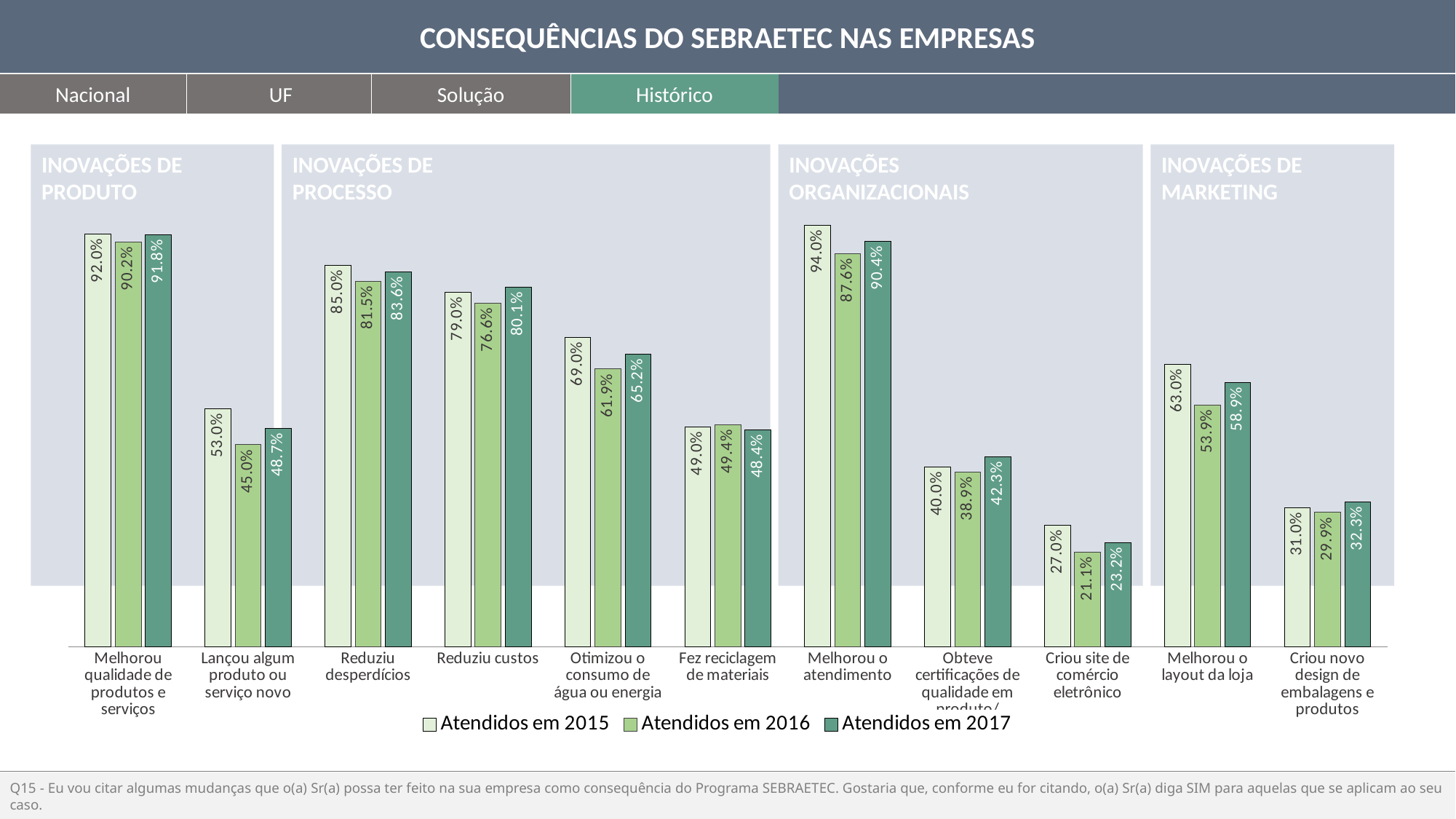
What is the difference between the "Atendidos em 2015" and "Atendidos em 2016" values for "Melhorou o layout da loja"? 9.1% Which category has the lowest value in the "Atendidos em 2015" series? Criou site de comércio eletrônico For "Lançou algum produto ou serviço novo", which is larger: the "Atendidos em 2016" value or the "Atendidos em 2017" value? Atendidos em 2017 How many categories are shown on the x axis of the chart? 11 What is the value for "Reduziu custos" in the "Atendidos em 2017" series? 80.1% What is the value for "Melhorou o atendimento" in the "Atendidos em 2015" series? 94.0% How many series does the legend list? 3 What is the value for "Criou site de comércio eletrônico" in the "Atendidos em 2016" series? 21.1% What kind of chart is shown on the slide? Bar chart Which category has the highest value in the "Atendidos em 2017" series? Melhorou qualidade de produtos e serviços What is the value for "Otimizou o consumo de água ou energia" in the "Atendidos em 2016" series? 61.9% Which group heading covers the categories "Melhorou o atendimento", "Obteve certificações de qualidade" and "Criou site de comércio eletrônico"? INOVAÇÕES ORGANIZACIONAIS